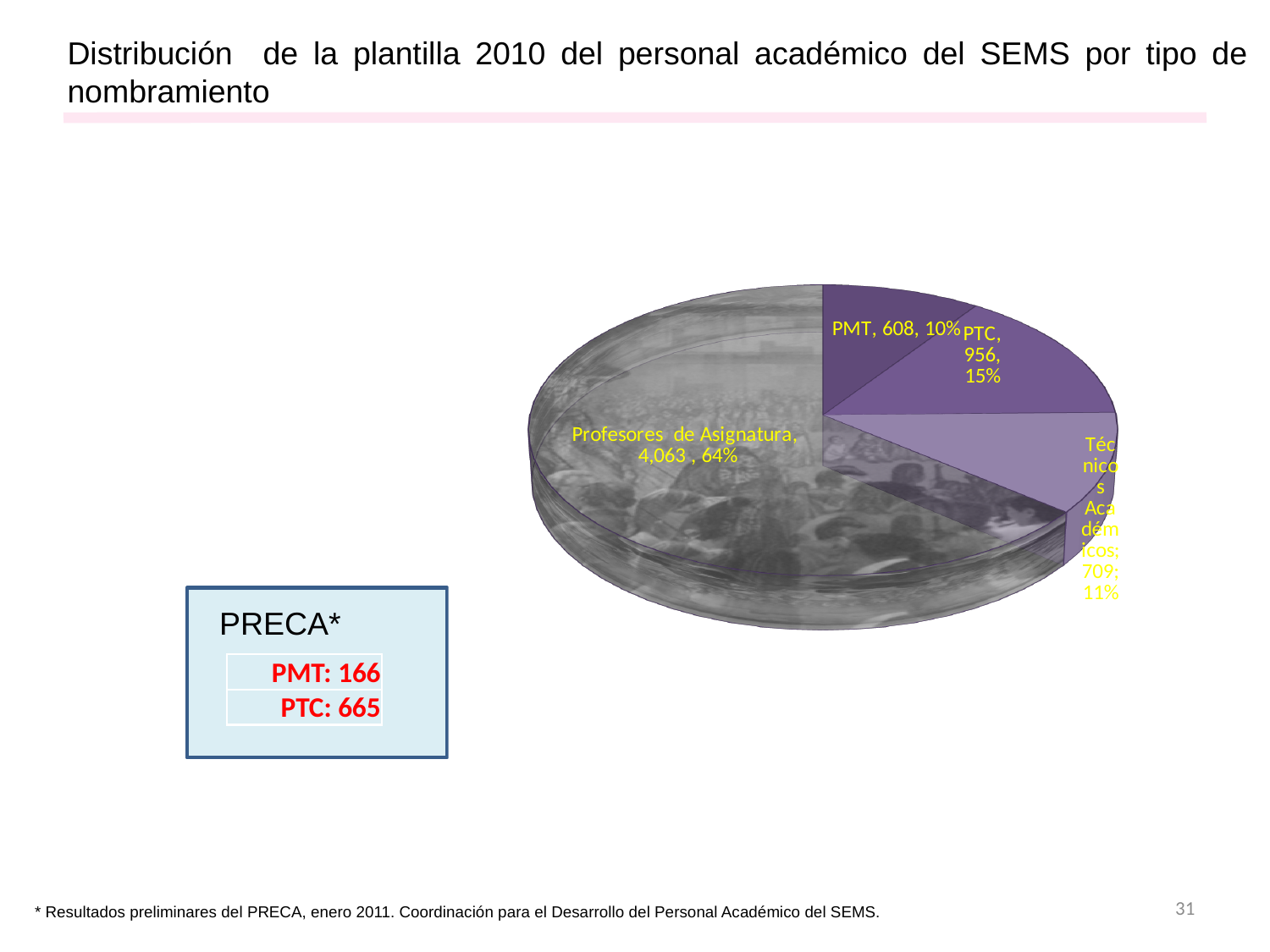
What is the difference between the values for PTC and PMT? 348 What is the value for Técnicos Académicos? 709 What is the value for PTC? 956 What share of the pie does PTC represent? 15% Which category has the largest slice? Profesores de Asignatura How many slices does the pie chart have? 4 What is the value for PMT? 608 What share of the pie does Profesores de Asignatura represent? 64% Which category has the smallest slice? PMT Which is larger, the value for Técnicos Académicos or the value for PMT? Técnicos Académicos What is the value for Profesores de Asignatura? 4,063 What kind of chart is shown on the slide? pie chart